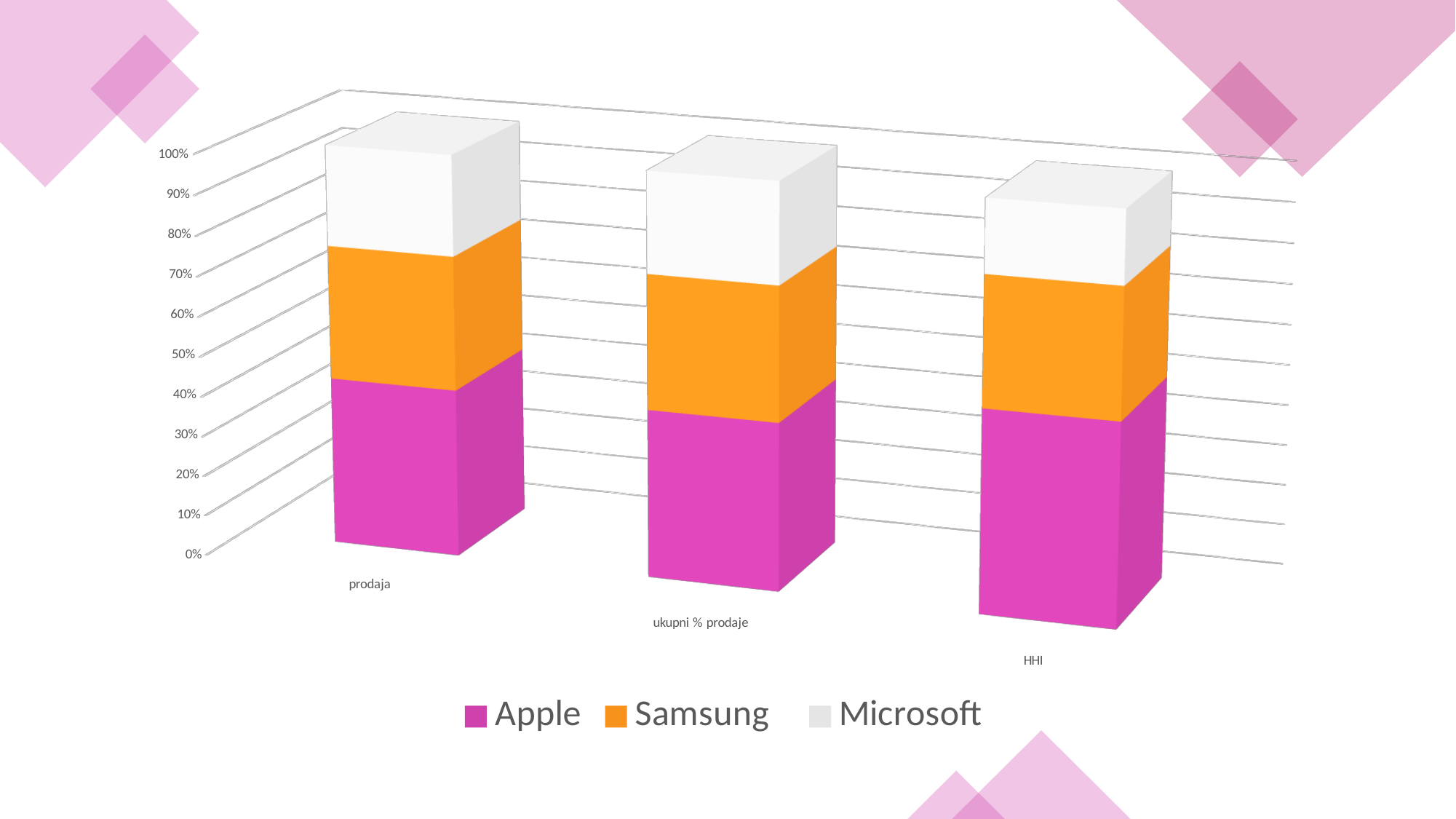
Is the Apple value for HHI greater or less than 10%? greater Is the Microsoft value for prodaja greater or less than 50%? less Which category has the larger Apple share: prodaja or HHI? HHI Which series are listed in the chart's legend? Apple, Samsung, Microsoft What kind of chart is shown on the slide? Stacked bar chart What is the highest value shown on the chart's vertical axis? 100% Which colour represents Samsung in the chart? Orange Is the Apple value for prodaja greater or less than 80%? less How many categories are shown on the x axis of the chart? 3 How many series does the chart's legend list? 3